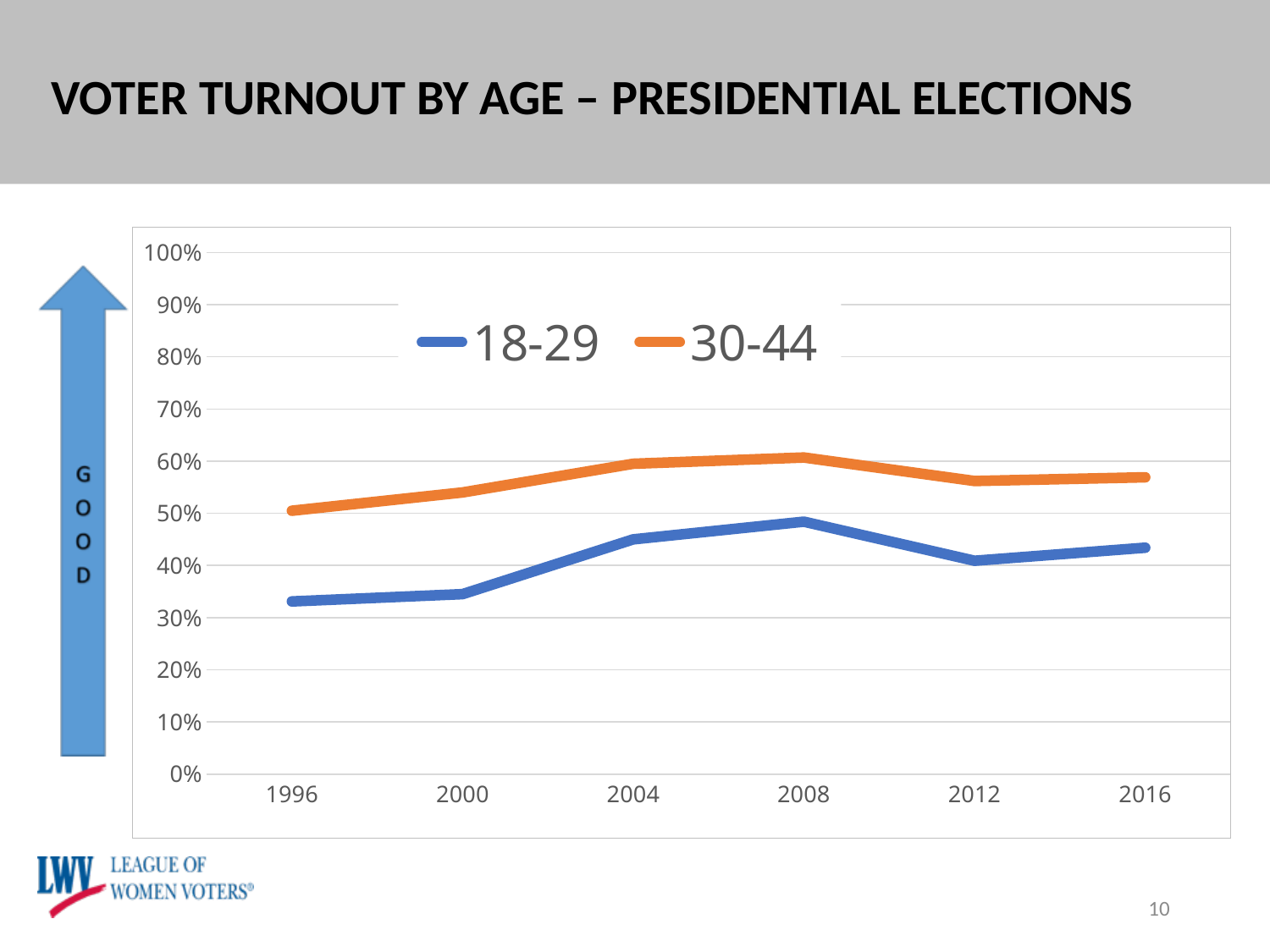
In which year does the 18-29 series reach its highest turnout? 2008 Is the value for 18-29 in 1996 greater or less than 40%? less In 2008, which age group has the higher turnout, 18-29 or 30-44? 30-44 What kind of chart is shown on the slide? line chart Is the value for 18-29 in 2004 greater or less than 40%? greater How many series does the legend list? 2 In which year is the 30-44 series at its lowest? 1996 Does the 18-29 series rise or fall from 1996 to 2008? rise What is the title of the slide containing the chart? VOTER TURNOUT BY AGE – PRESIDENTIAL ELECTIONS Is the value for 30-44 in 2004 greater or less than 50%? greater Which colour represents the 30-44 series in the legend? orange How many election years are plotted along the x axis? 6